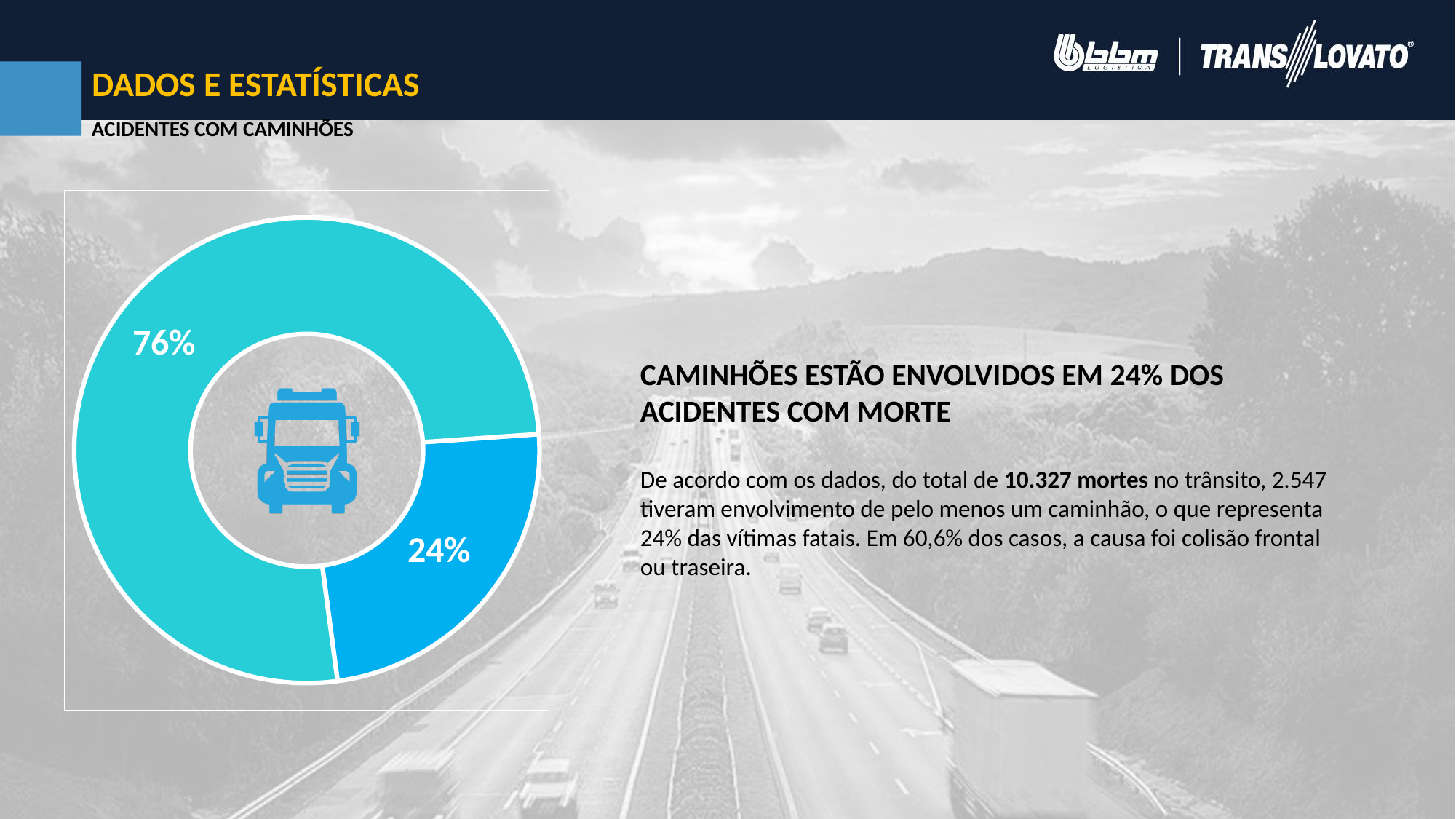
What colour is the 76% slice of the donut chart? Light turquoise/cyan What is the value of the largest slice in the donut chart? 76% What share of the donut chart does the darker blue slice represent? 24% According to the slide, what percentage of fatal accidents involve trucks? 24% Which slice is larger, the 76% slice or the 24% slice? The 76% slice What icon is shown in the centre of the donut chart? A truck Is the smaller slice of the donut chart greater or less than 50%? less What do the two slices of the donut chart add up to? 100% What is the value of the smallest slice in the donut chart? 24% What is the difference between the two slices of the donut chart? 52 percentage points What kind of chart is shown on the slide? Donut (pie) chart How many slices does the donut chart have? 2